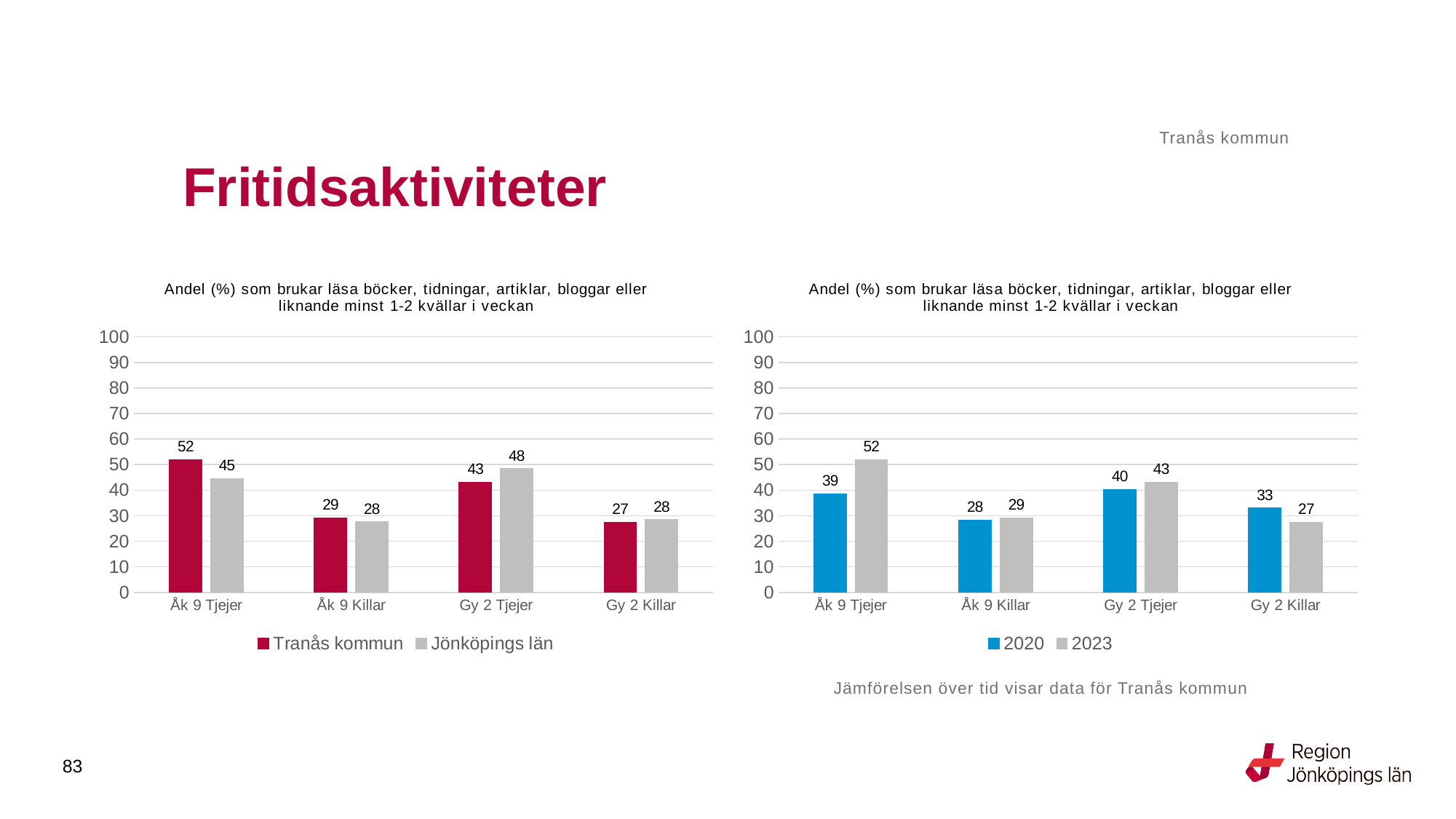
How many series does the legend of the right chart list? 2 In the right chart, which is larger for Gy 2 Killar: the 2020 value or the 2023 value? 2020 In the left chart, what is the value for Jönköpings län for Gy 2 Tjejer? 48 How many categories are shown on the x axis of the left chart? 4 In the right chart, what is the value for 2020 for Gy 2 Killar? 33 In the left chart, what is the value for Tranås kommun for Åk 9 Tjejer? 52 In the left chart, which category has the highest value for Tranås kommun? Åk 9 Tjejer In the right chart, what is the difference between the 2023 and 2020 values for Åk 9 Tjejer? 13 In the left chart, what is the difference between the Tranås kommun and Jönköpings län values for Åk 9 Tjejer? 7 What type of chart is the left chart? Bar chart In the right chart, which category has the lowest value for 2020? Åk 9 Killar In the right chart, what is the value for 2023 for Åk 9 Tjejer? 52